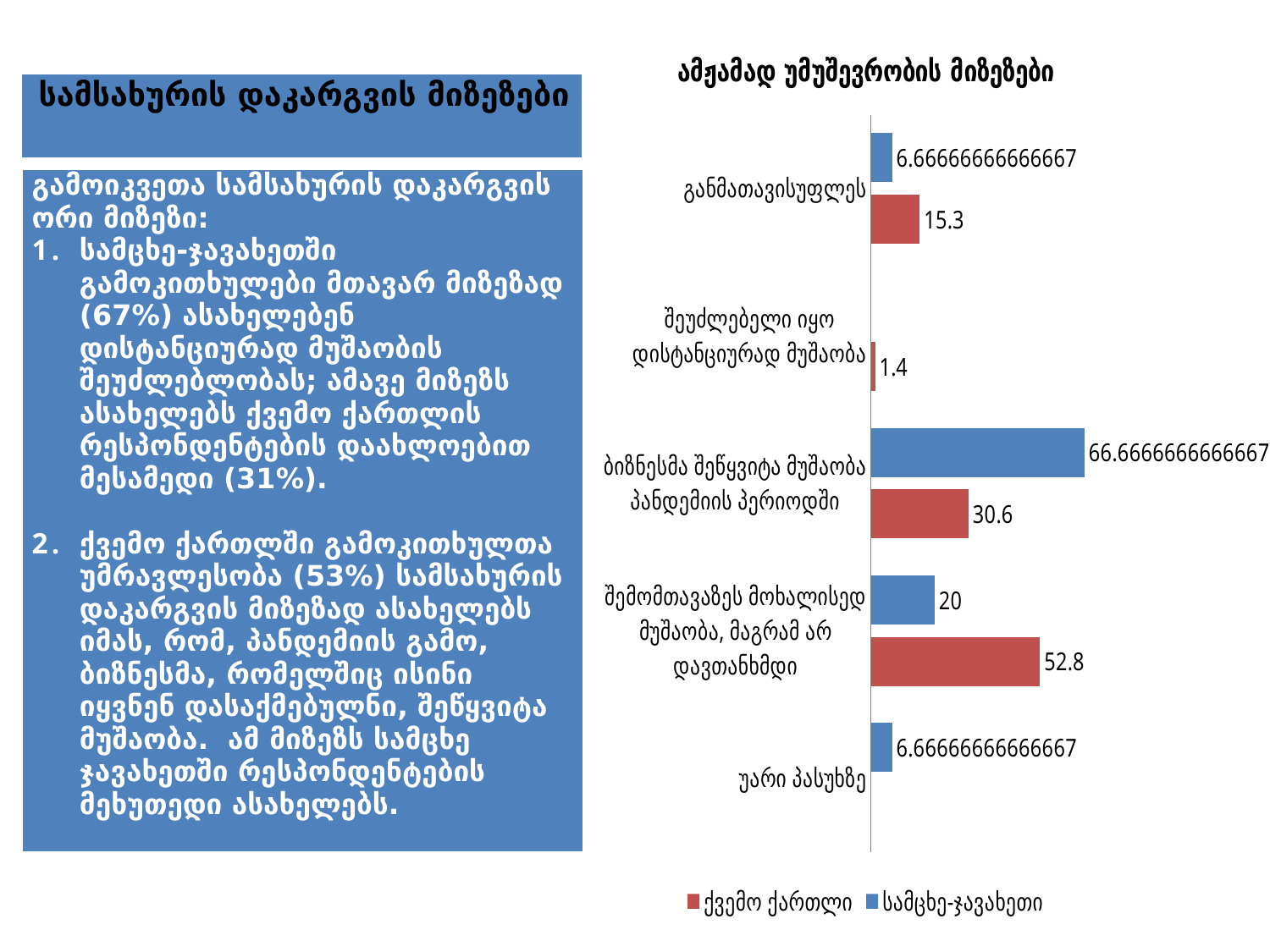
What is the value for ქვემო ქართლი in the category ბიზნესმა შეწყვიტა მუშაობა პანდემიის პერიოდში? 30.6 How many series does the chart legend list? 2 In the category განმათავისუფლეს, which series has the larger value, ქვემო ქართლი or სამცხე-ჯავახეთი? ქვემო ქართლი What is the value for ქვემო ქართლი in the category შემომთავაზეს მოხალისედ მუშაობა, მაგრამ არ დავთანხმდი? 52.8 What is the value for ქვემო ქართლი in the category განმათავისუფლეს? 15.3 What is the difference between the ქვემო ქართლი and სამცხე-ჯავახეთი values in the category შემომთავაზეს მოხალისედ მუშაობა, მაგრამ არ დავთანხმდი? 32.8 Which category has the lowest value for ქვემო ქართლი? შეუძლებელი იყო დისტანციურად მუშაობა What is the value for სამცხე-ჯავახეთი in the category ბიზნესმა შეწყვიტა მუშაობა პანდემიის პერიოდში? 66.6666666666667 How many categories are shown on the chart's vertical axis? 5 What type of chart is shown on the slide? bar chart What is the title of the chart? ამჟამად უმუშევრობის მიზეზები Which category has the highest value for ქვემო ქართლი? შემომთავაზეს მოხალისედ მუშაობა, მაგრამ არ დავთანხმდი